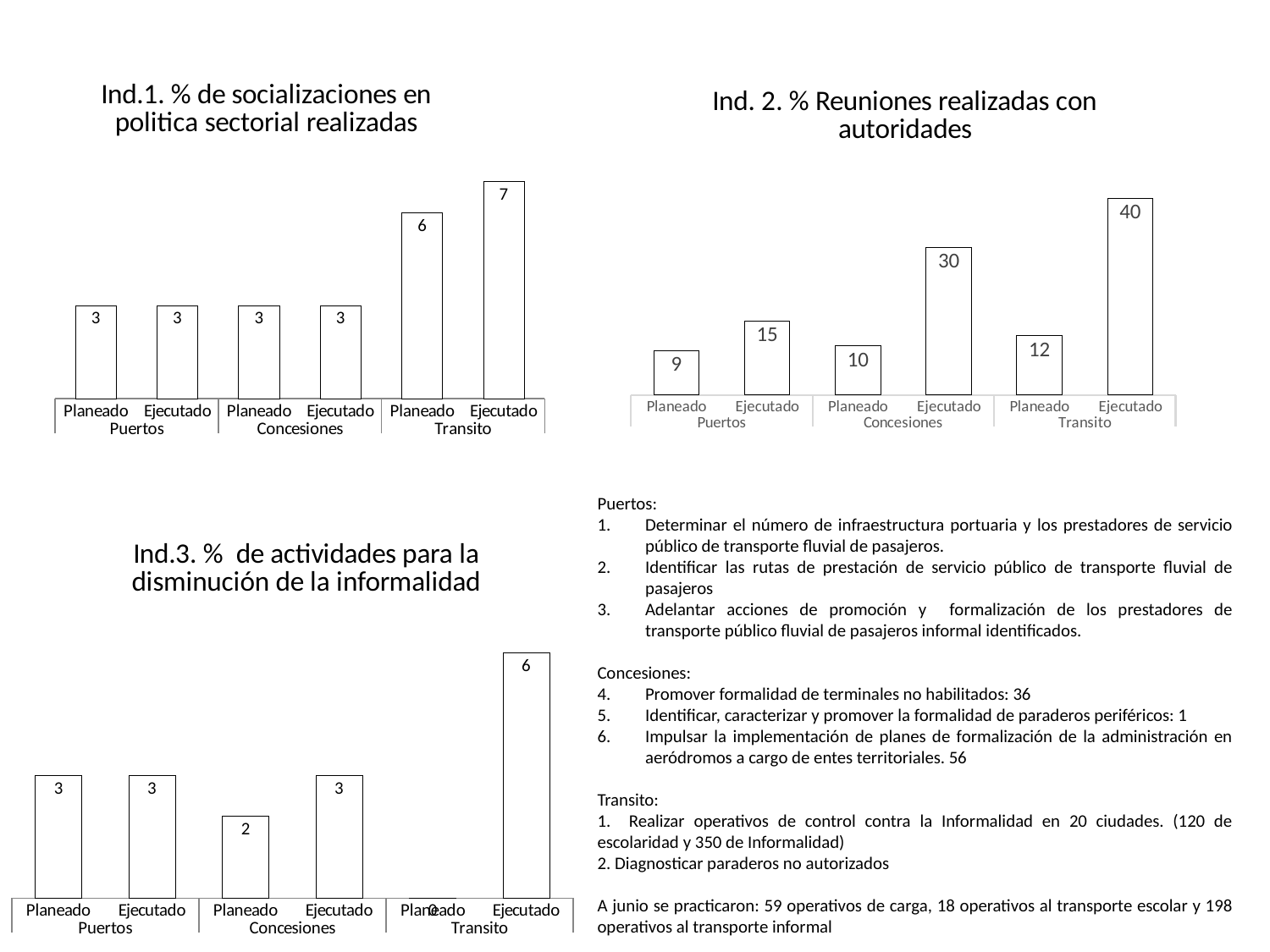
In the chart 'Ind.3. % de actividades para la disminución de la informalidad', what is the Ejecutado value for Transito? 6 In the chart 'Ind. 2. % Reuniones realizadas con autoridades', which bar is the highest? Transito Ejecutado In the chart 'Ind.3. % de actividades para la disminución de la informalidad', what is the difference between the Ejecutado and Planeado values for Concesiones? 1 What type of chart is 'Ind.3. % de actividades para la disminución de la informalidad'? bar chart In the chart 'Ind.3. % de actividades para la disminución de la informalidad', what is the Planeado value for Concesiones? 2 In the chart 'Ind.1. % de socializaciones en politica sectorial realizadas', what is the Ejecutado value for Transito? 7 In the chart 'Ind.1. % de socializaciones en politica sectorial realizadas', is the Planeado value for Transito larger or smaller than the Ejecutado value for Transito? smaller In the chart 'Ind. 2. % Reuniones realizadas con autoridades', what is the difference between the Ejecutado and Planeado values for Concesiones? 20 In the chart 'Ind. 2. % Reuniones realizadas con autoridades', what is the Planeado value for Puertos? 9 In the chart 'Ind. 2. % Reuniones realizadas con autoridades', what is the Ejecutado value for Transito? 40 How many bars are plotted in the chart 'Ind. 2. % Reuniones realizadas con autoridades'? 6 In the chart 'Ind.1. % de socializaciones en politica sectorial realizadas', which bar is the lowest? Puertos Planeado, Puertos Ejecutado, Concesiones Planeado and Concesiones Ejecutado (all 3)